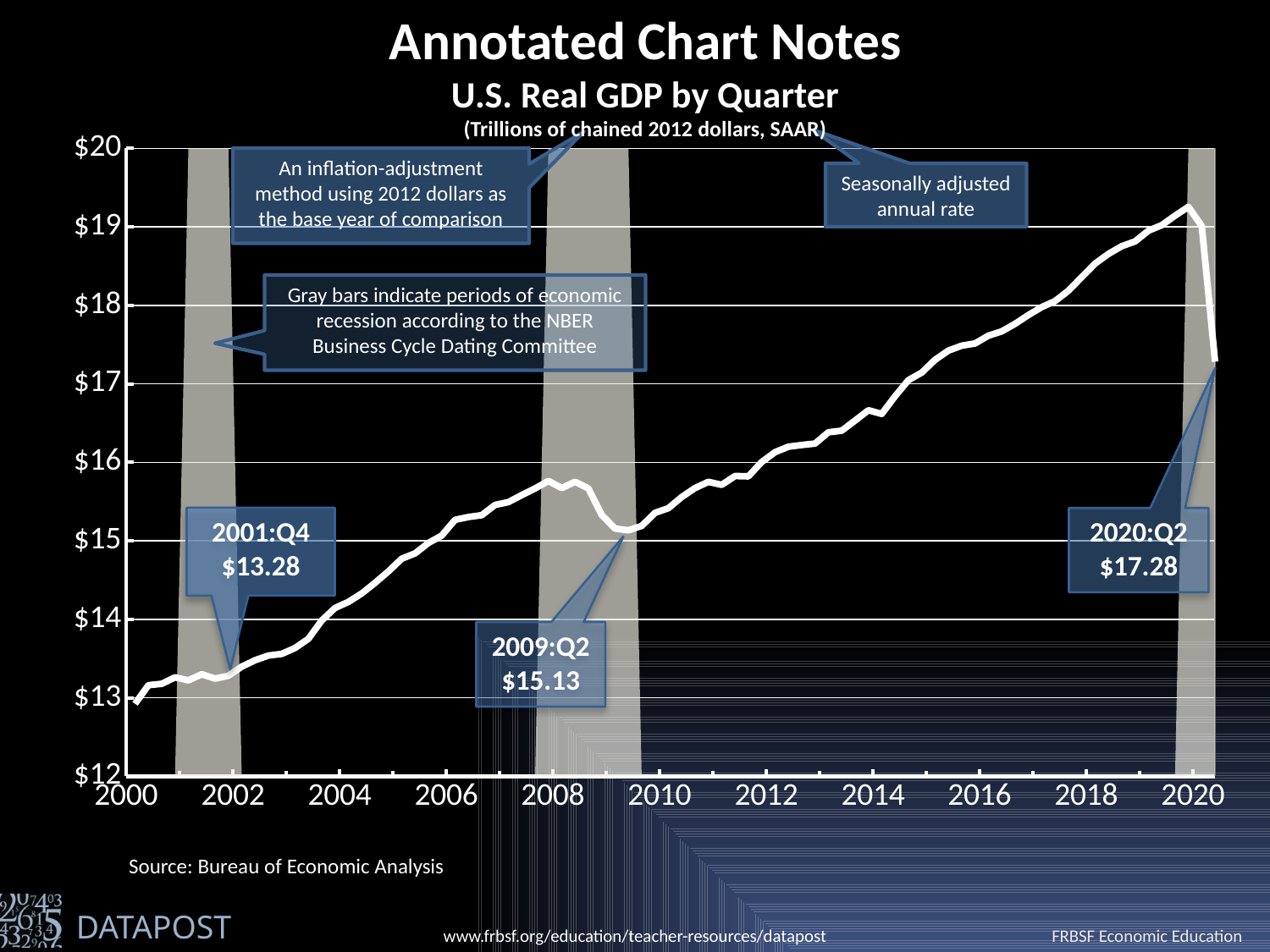
Is the value for 2010 greater or less than $16? less What value is annotated for 2009:Q2 on the chart? $15.13 According to the annotation, what do the gray bars on the chart indicate? Periods of economic recession according to the NBER Business Cycle Dating Committee What kind of chart is shown on the slide? line chart Does real GDP generally rise or fall from 2000 to 2019 on the chart? rise Which annotated quarter has the larger value, 2009:Q2 or 2020:Q2? 2020:Q2 What value is annotated for 2001:Q4 on the U.S. Real GDP chart? $13.28 What is the difference between the annotated values for 2020:Q2 and 2001:Q4? $4.00 Is the value for 2014 greater or less than $16? greater What is the difference between the annotated values for 2009:Q2 and 2001:Q4? $1.85 Of the three annotated quarters, which has the lowest value? 2001:Q4 What value is annotated for 2020:Q2 on the chart? $17.28